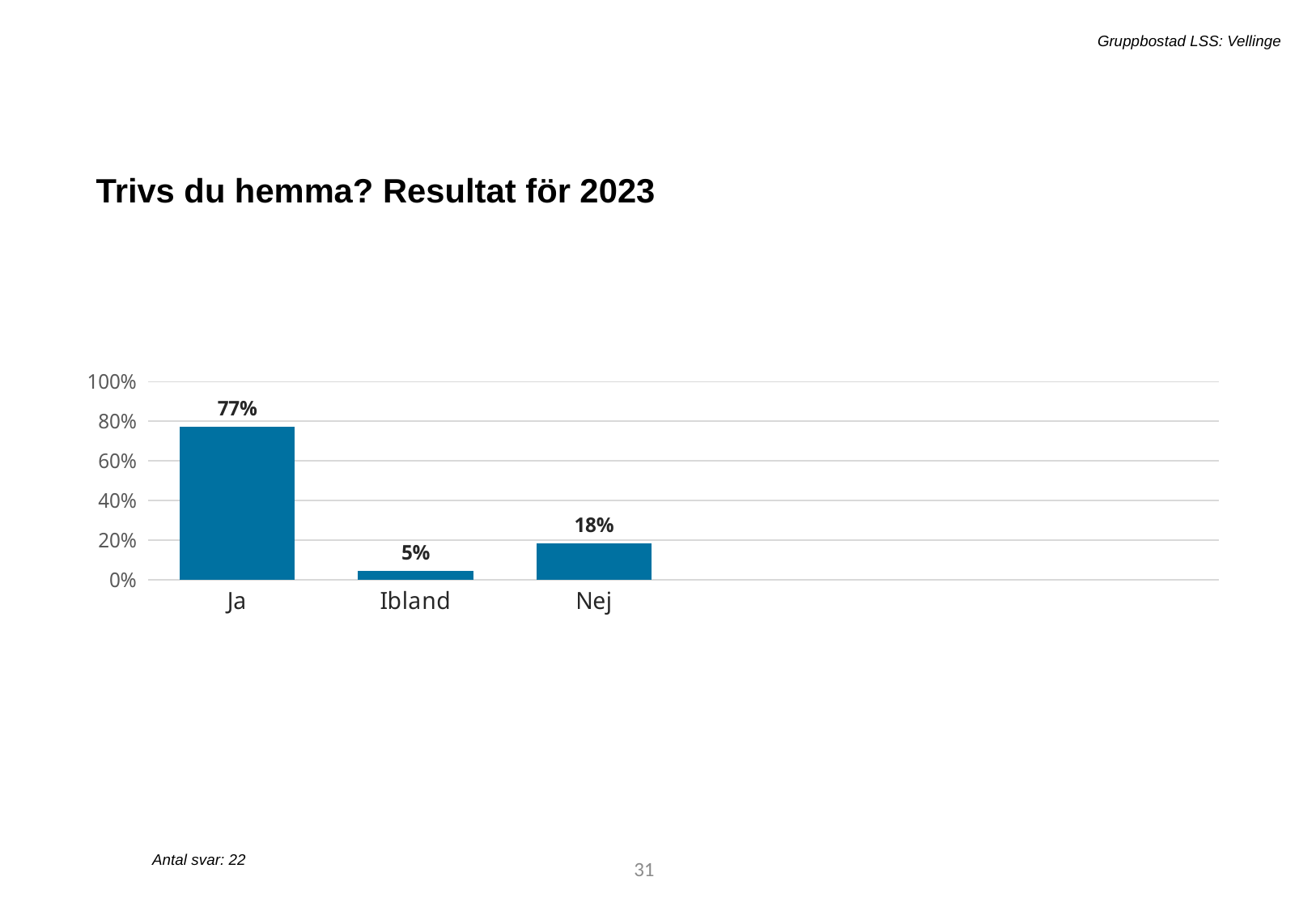
What is the value for Nej? 18% Which category has the lowest value? Ibland What is the difference between the values for Ja and Nej? 59% What is the difference between the values for Nej and Ibland? 13% What kind of chart is shown on the slide? bar chart What is the value for Ja? 77% Which category has the highest value? Ja Which is larger, the value for Nej or the value for Ibland? Nej What is the title of the chart? Trivs du hemma? Resultat för 2023 Is the value for Ja greater or less than 60%? greater What is the value for Ibland? 5% How many categories are shown on the x axis? 3